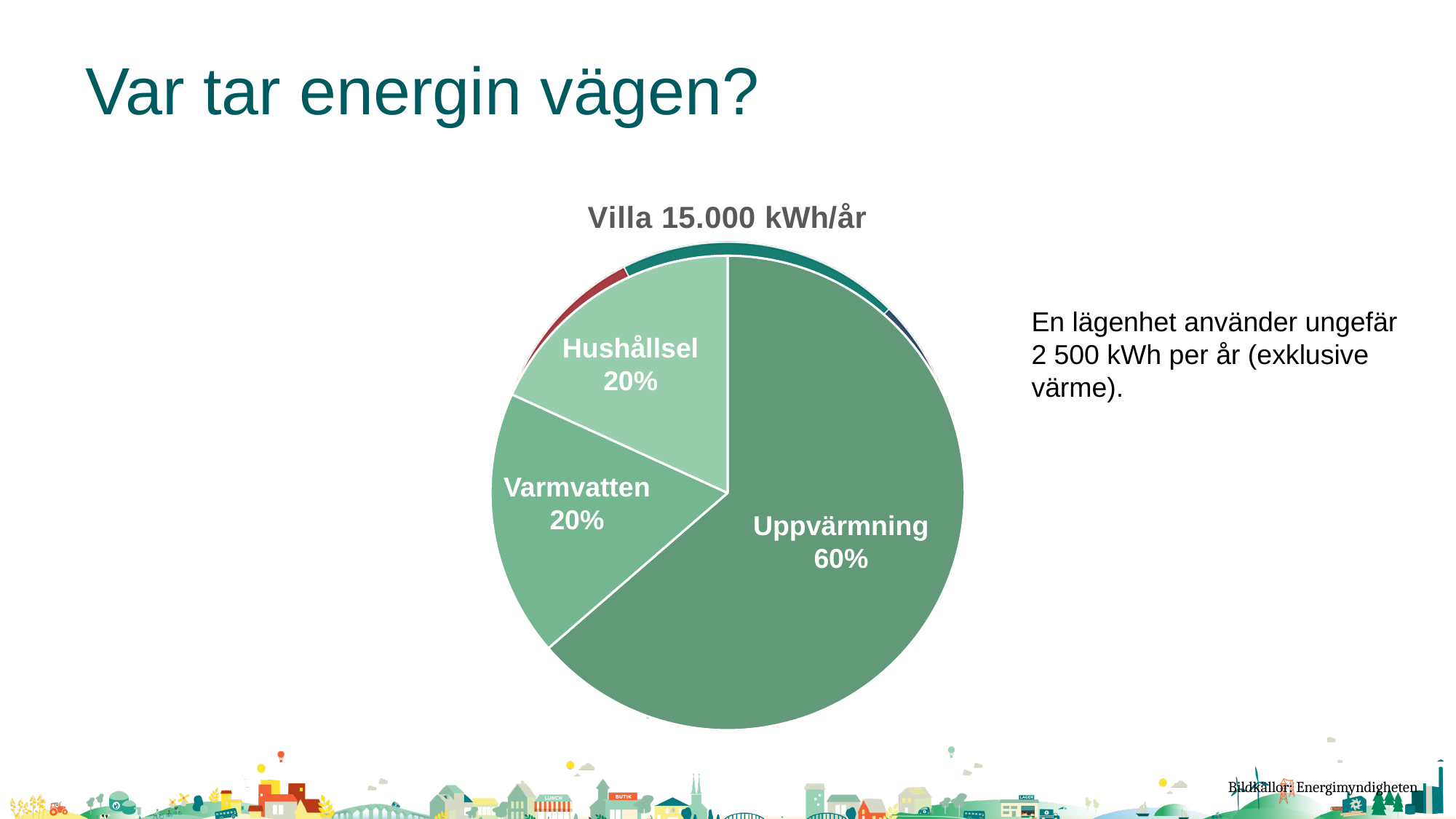
Which is larger, the slice for Uppvärmning or the slice for Hushållsel? Uppvärmning What is the title of the pie chart? Villa 15.000 kWh/år Which category has the largest slice of the pie? Uppvärmning What combined share do Varmvatten and Hushållsel make up together? 40% How many percentage points larger is Uppvärmning than Varmvatten? 40 Is the share for Uppvärmning greater or less than 50%? greater What share of the pie does Uppvärmning account for? 60% How many slices does the pie chart have? 3 Which slice of the pie is drawn in the darkest green? Uppvärmning What percentage is shown for Hushållsel? 20% What percentage is shown for Varmvatten? 20% What kind of chart is shown on the slide? Pie chart